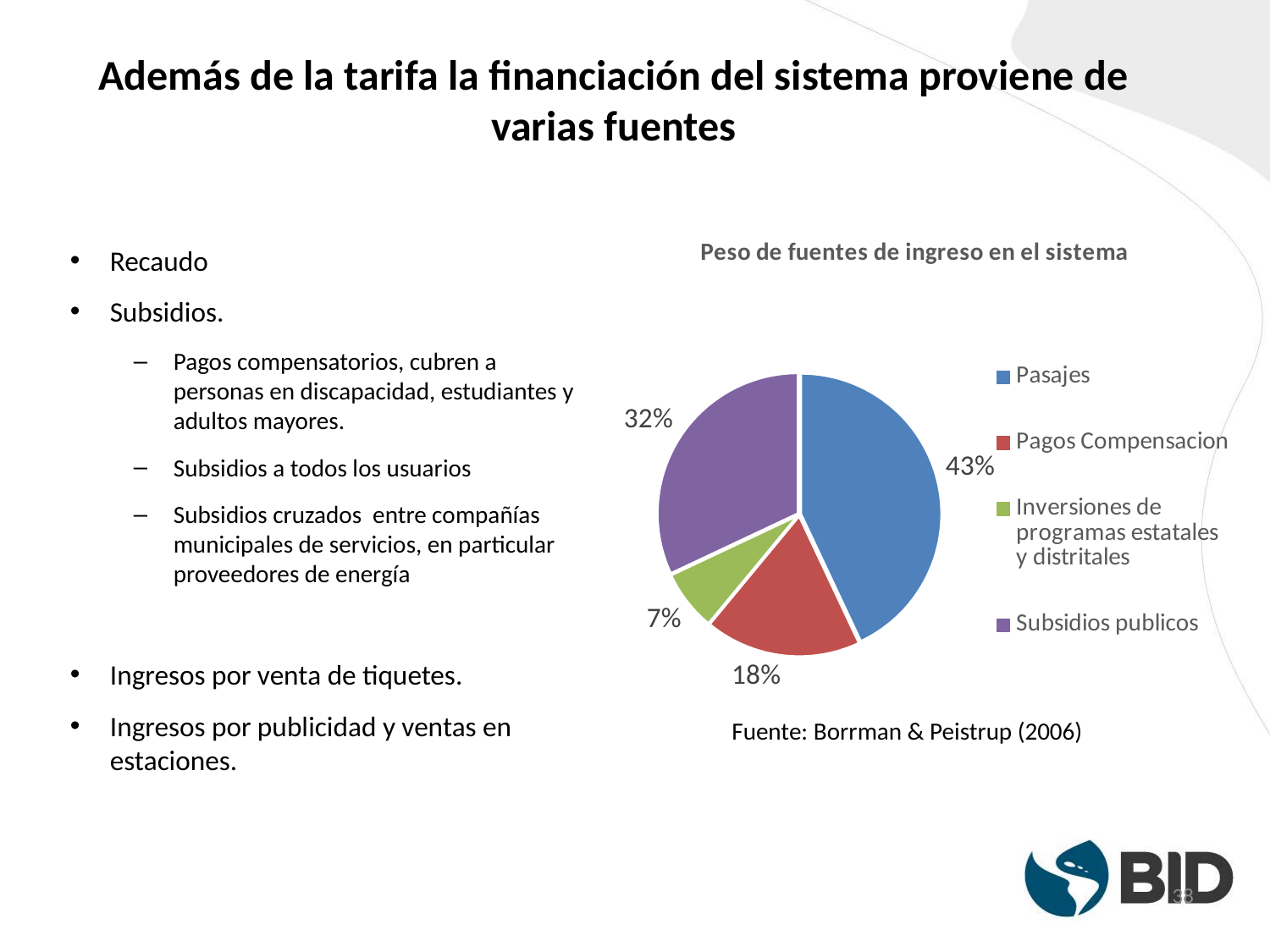
What colour is the slice for Subsidios publicos? purple What is the title of the chart? Peso de fuentes de ingreso en el sistema Which category has the smallest slice of the pie? Inversiones de programas estatales y distritales What share of the pie does Pagos Compensacion represent? 18% What share of the pie does Pasajes represent? 43% Which is larger, Pagos Compensacion or Subsidios publicos? Subsidios publicos What share of the pie does Subsidios publicos represent? 32% What is the difference in percentage points between Pasajes and Subsidios publicos? 11 Which category has the largest slice of the pie? Pasajes What kind of chart is shown on the slide? pie chart How many categories does the pie chart show? 4